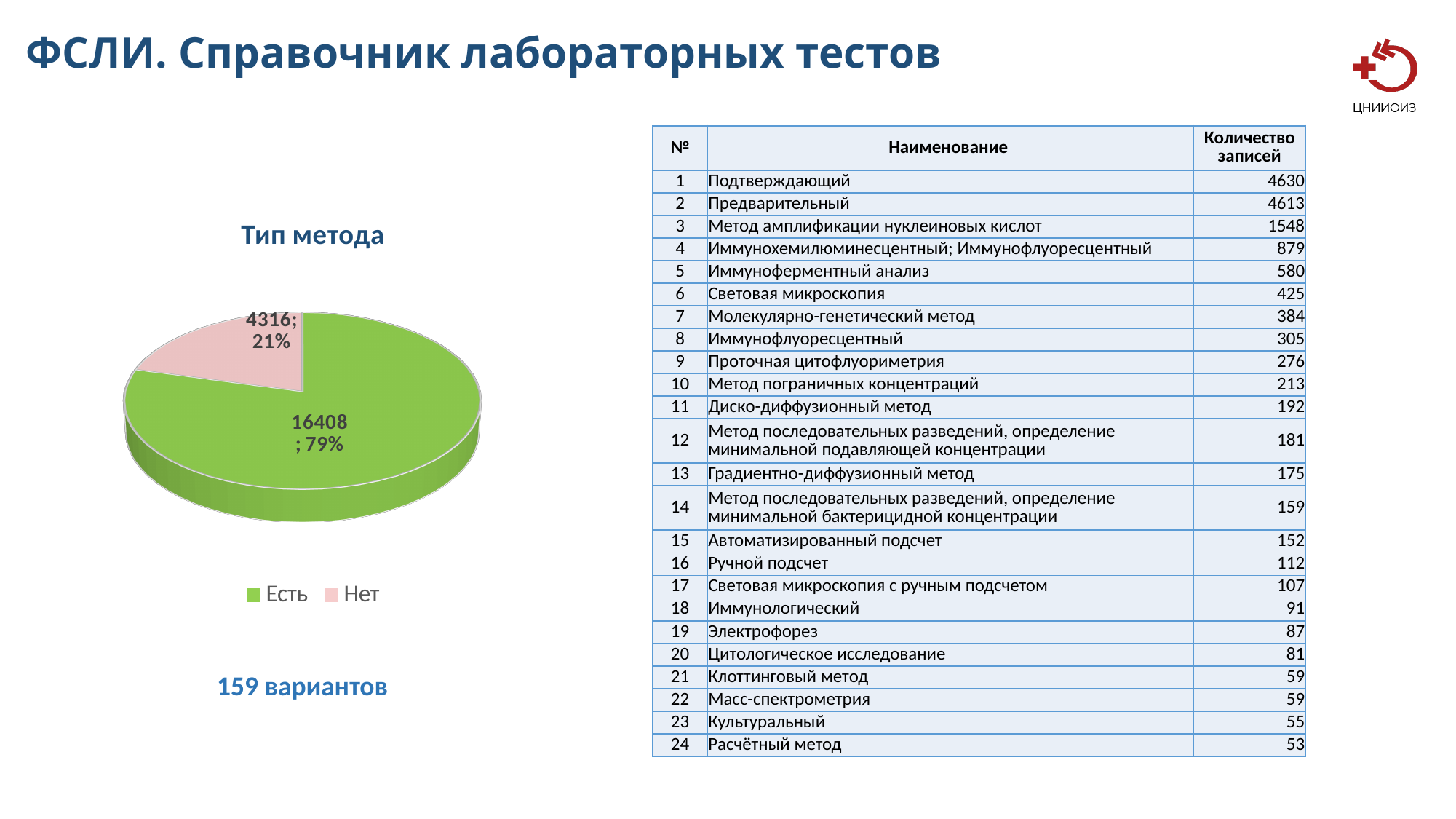
How many slices does the "Тип метода" pie chart have? 2 Which slice of the "Тип метода" pie chart is the smallest? Нет What kind of chart is shown under the title "Тип метода"? pie chart What share of the "Тип метода" pie does "Есть" take? 79% What share of the "Тип метода" pie does "Нет" take? 21% In the "Тип метода" pie chart, which is larger: "Есть" or "Нет"? Есть What is the value for "Нет" in the "Тип метода" pie chart? 4316 Which slice of the "Тип метода" pie chart is the largest? Есть What colour is the "Нет" slice in the "Тип метода" pie chart? pink What is the total of the two slices in the "Тип метода" pie chart? 20724 What is the difference between the values for "Есть" and "Нет" in the "Тип метода" pie chart? 12092 What is the value for "Есть" in the "Тип метода" pie chart? 16408